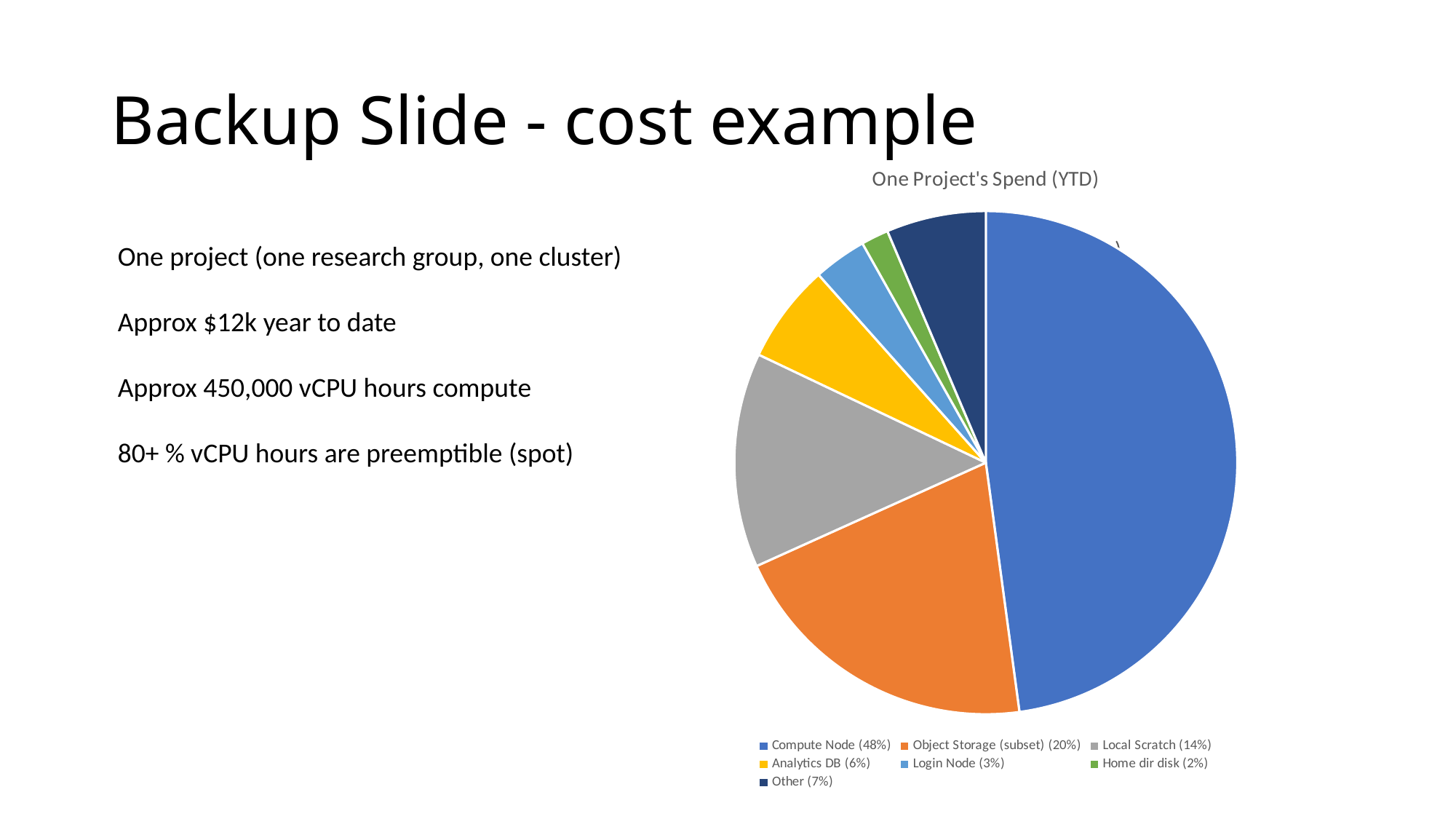
Which category has the smallest share of the pie? Home dir disk What is the difference in percentage points between the Compute Node share and the Object Storage (subset) share? 28 What kind of chart is shown on the slide? pie chart Which category has the largest share of the pie? Compute Node What share of the pie does Object Storage (subset) account for? 20% What share of the pie does Compute Node account for? 48% What share of the pie does Local Scratch account for? 14% What colour is the Compute Node slice? blue What is the title of the chart? One Project's Spend (YTD) Which has a larger share, Local Scratch or Other? Local Scratch How many categories does the pie chart have? 7